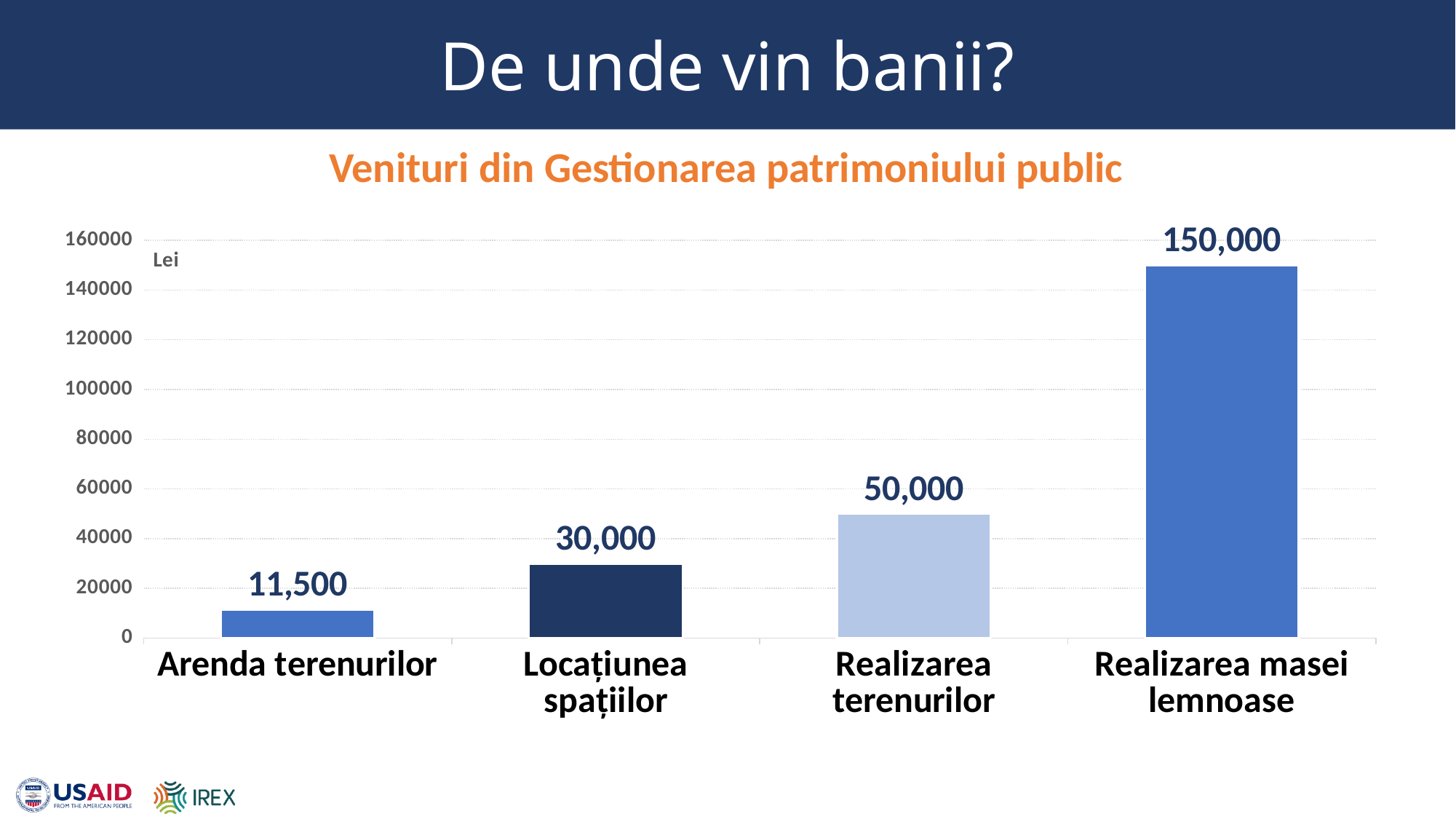
What is the difference between Locațiunea spațiilor and Arenda terenurilor? 18,500 What is the value for Realizarea terenurilor? 50,000 What is the value for Locațiunea spațiilor? 30,000 What kind of chart is shown on the slide? Bar chart How many categories are shown in the chart? 4 What is the title of the chart? Venituri din Gestionarea patrimoniului public Which category has the highest value? Realizarea masei lemnoase Which is larger, Locațiunea spațiilor or Realizarea terenurilor? Realizarea terenurilor Which category has the lowest value? Arenda terenurilor What is the difference between Realizarea masei lemnoase and Realizarea terenurilor? 100,000 What is the value for Realizarea masei lemnoase? 150,000 What is the value for Arenda terenurilor? 11,500